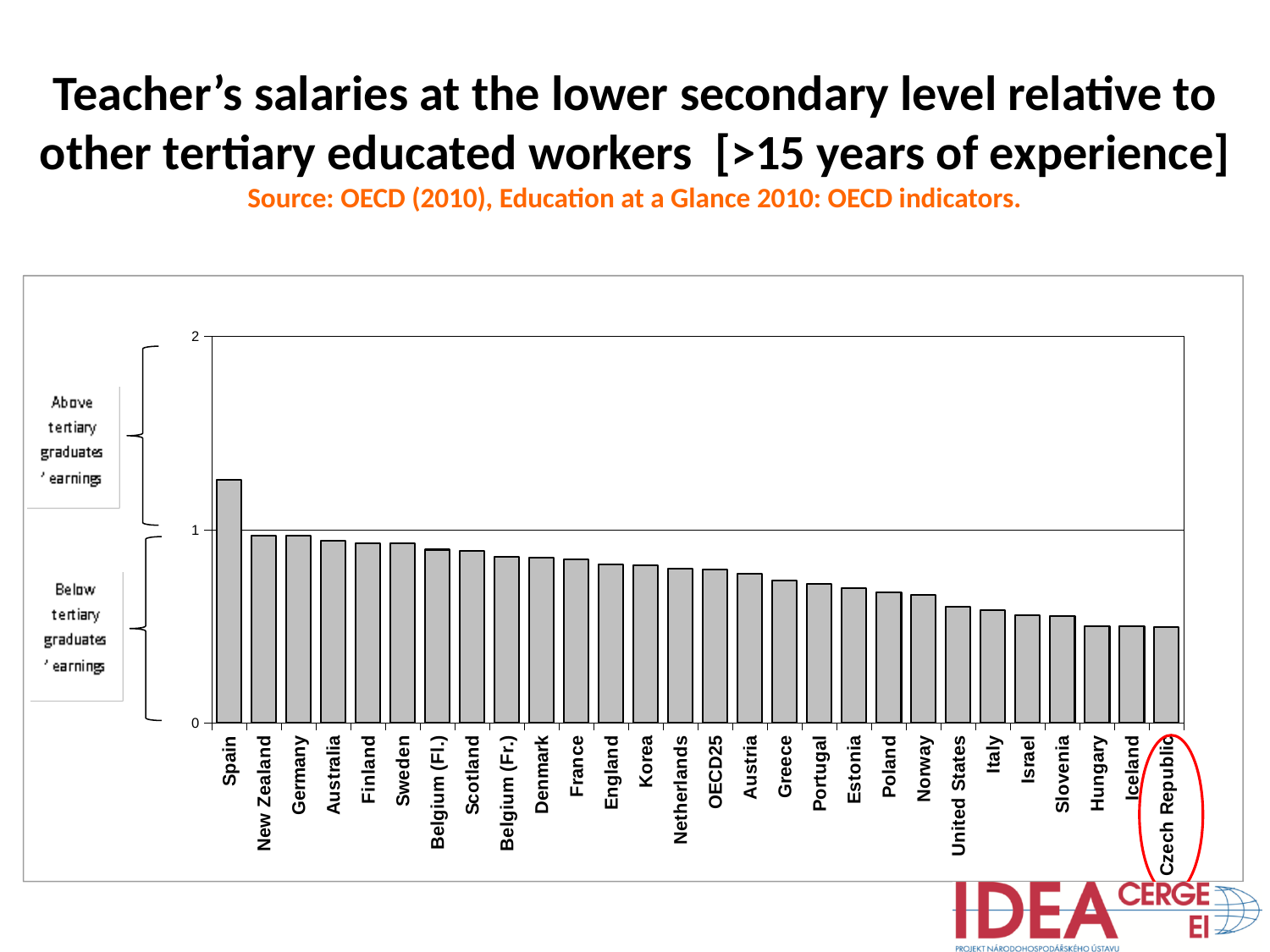
How many categories (bars) are plotted in the chart? 28 Is the value for Norway greater or less than 1? less Which has a larger value, Korea or Hungary? Korea Which has a larger value, New Zealand or Italy? New Zealand Which has a larger value, Spain or Czech Republic? Spain Do the bar values rise or fall moving from left to right along the x axis? fall Is the value for Spain greater or less than 1? greater Which country's label is circled in red on the chart? Czech Republic Is the value for Italy greater or less than 1? less Which country has the highest value in the chart? Spain What kind of chart is shown on the slide? bar chart